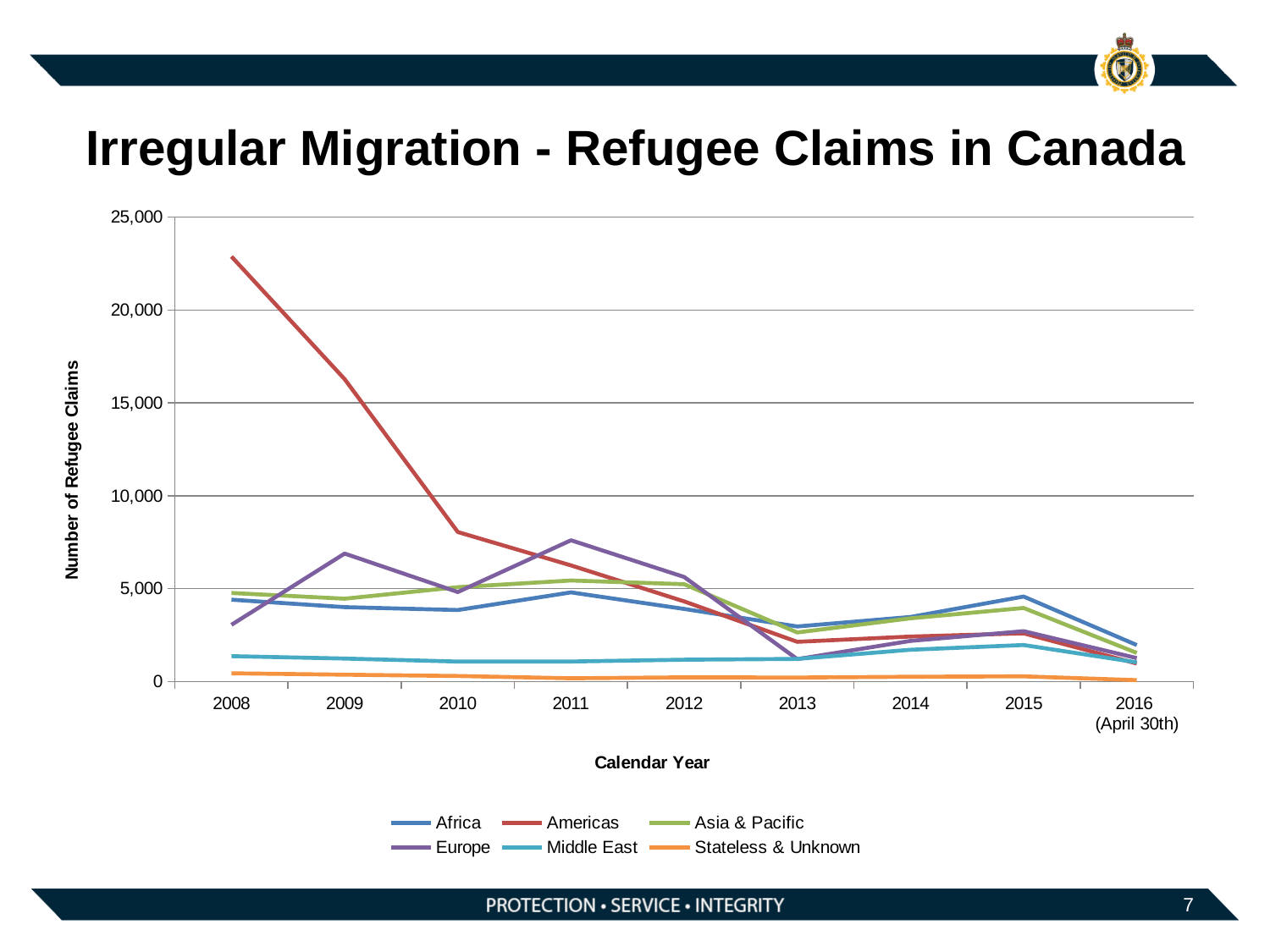
Is the value for Americas in 2010 greater or less than 10,000? less What kind of chart is shown on the slide? line chart What is the title of the y axis? Number of Refugee Claims Which series has the highest number of refugee claims in 2011? Europe How many series does the legend list? 6 What is the title of the x axis? Calendar Year How many calendar years are shown along the x axis? 9 Which series has the lowest number of refugee claims in 2008? Stateless & Unknown Is the value for Europe in 2011 greater or less than 5,000? greater Which series has the highest number of refugee claims in 2008? Americas Is the value for Americas in 2008 greater or less than 20,000? greater Does the Americas line rise or fall from 2008 to 2013? fall